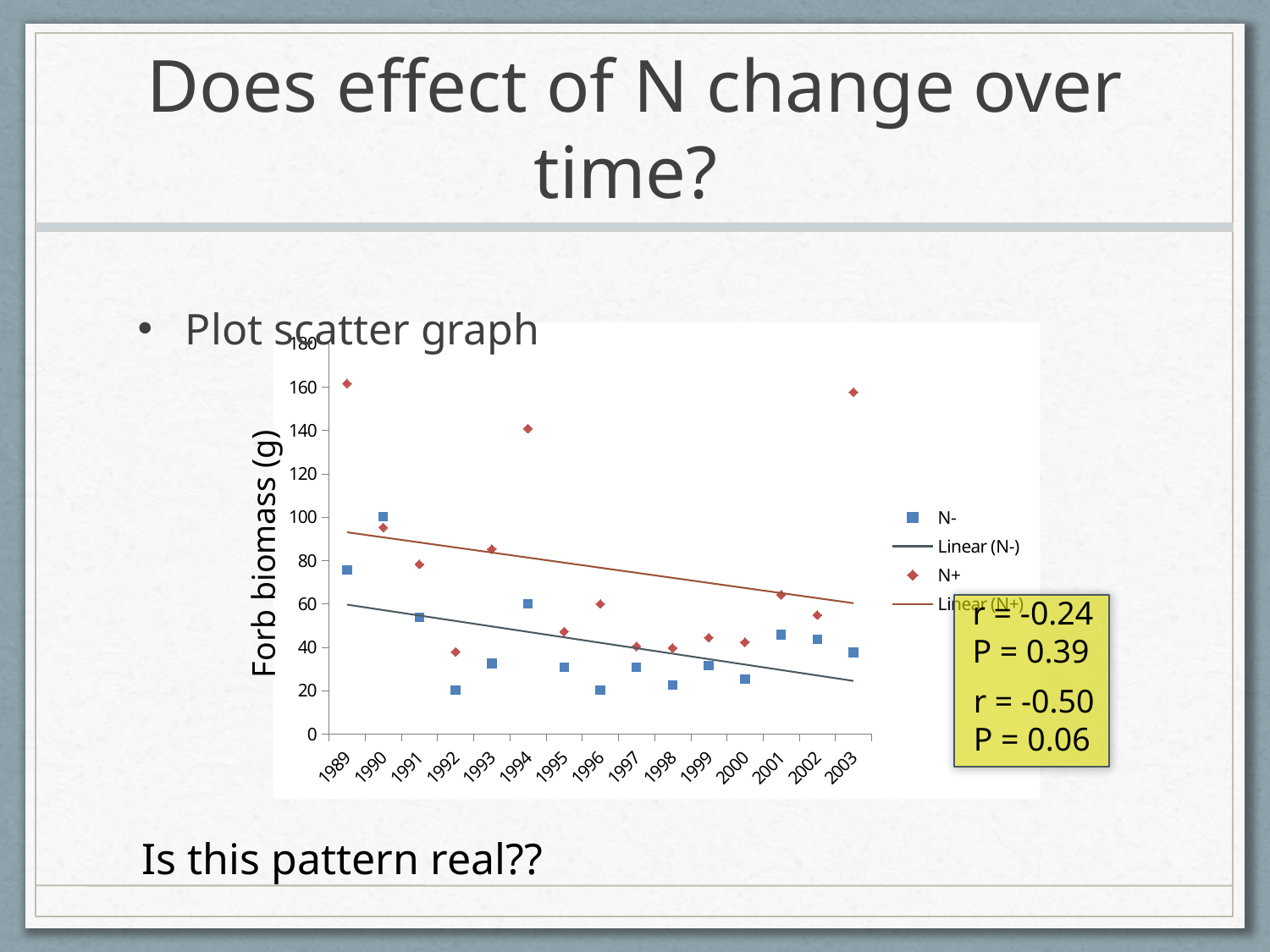
Is the N- value for 1990 greater or less than 80? greater How many years are shown along the x axis of the chart? 15 What kind of chart is shown on the slide? scatter chart Does the Linear (N+) trend line rise or fall from 1989 to 2003? fall In 1994, which series has the larger value, N+ or N-? N+ In 1989, which series has the larger value, N+ or N-? N+ What is the label of the y axis of the chart? Forb biomass (g) Which year has the highest N- value in the chart? 1990 How many entries does the chart's legend list? 4 Is the N+ value for 1989 greater or less than 140? greater Is the N- value for 1992 greater or less than 40? less